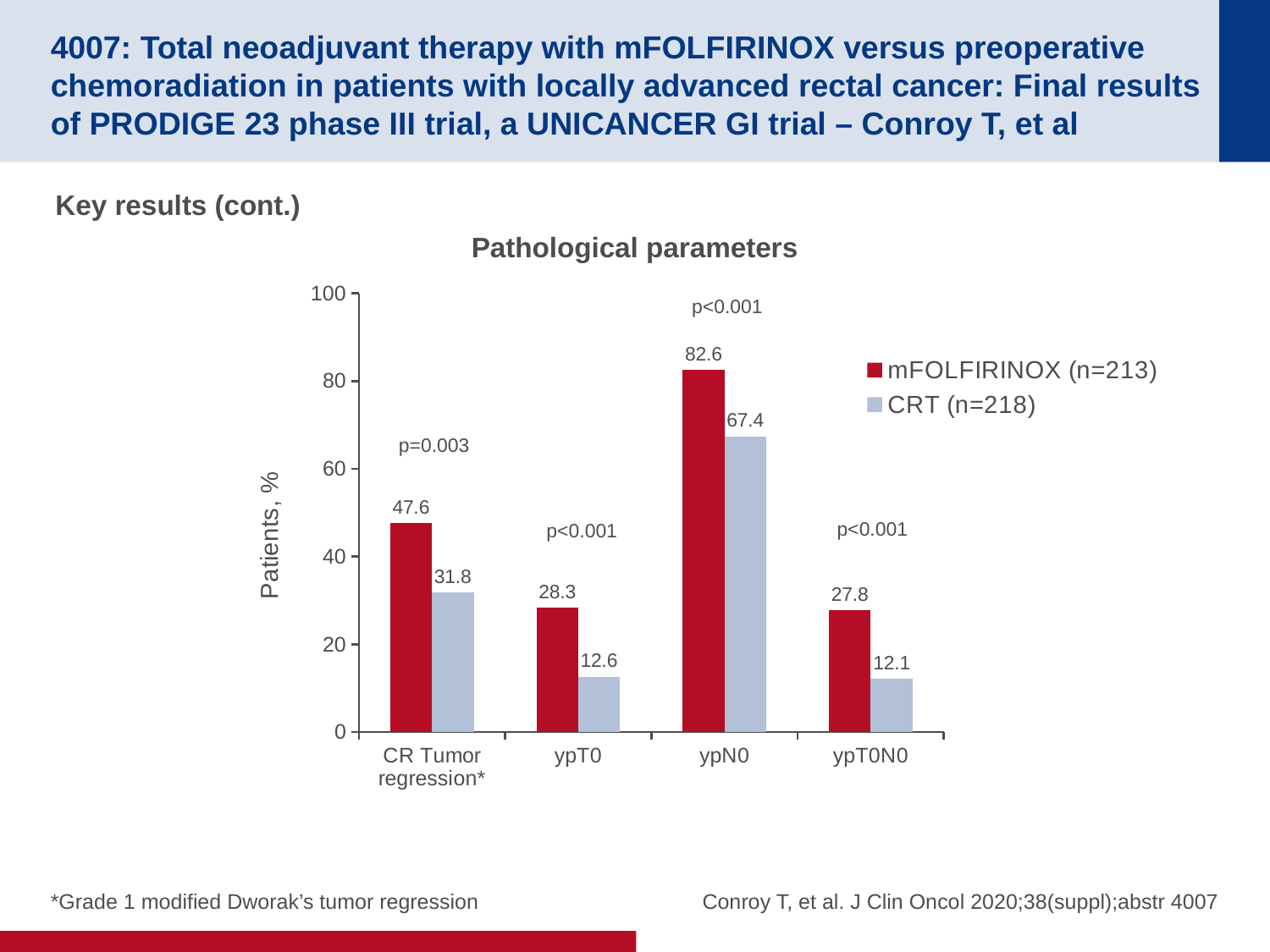
What is the value for CRT (n=218) in the ypT0N0 category? 12.1 Which category has the lowest value for CRT (n=218)? ypT0N0 Which is larger in the ypN0 category: mFOLFIRINOX (n=213) or CRT (n=218)? mFOLFIRINOX (n=213) How many series does the legend list? 2 What is the value for mFOLFIRINOX (n=213) in the ypN0 category? 82.6 Is the value for mFOLFIRINOX (n=213) in the CR Tumor regression* category greater or less than 40? greater What is the difference between the mFOLFIRINOX (n=213) and CRT (n=218) values in the ypT0 category? 15.7 What is the title of the chart? Pathological parameters How many categories are shown on the x axis? 4 What kind of chart is shown on the slide? Bar chart Which category has the highest value for mFOLFIRINOX (n=213)? ypN0 What is the value for CRT (n=218) in the CR Tumor regression* category? 31.8